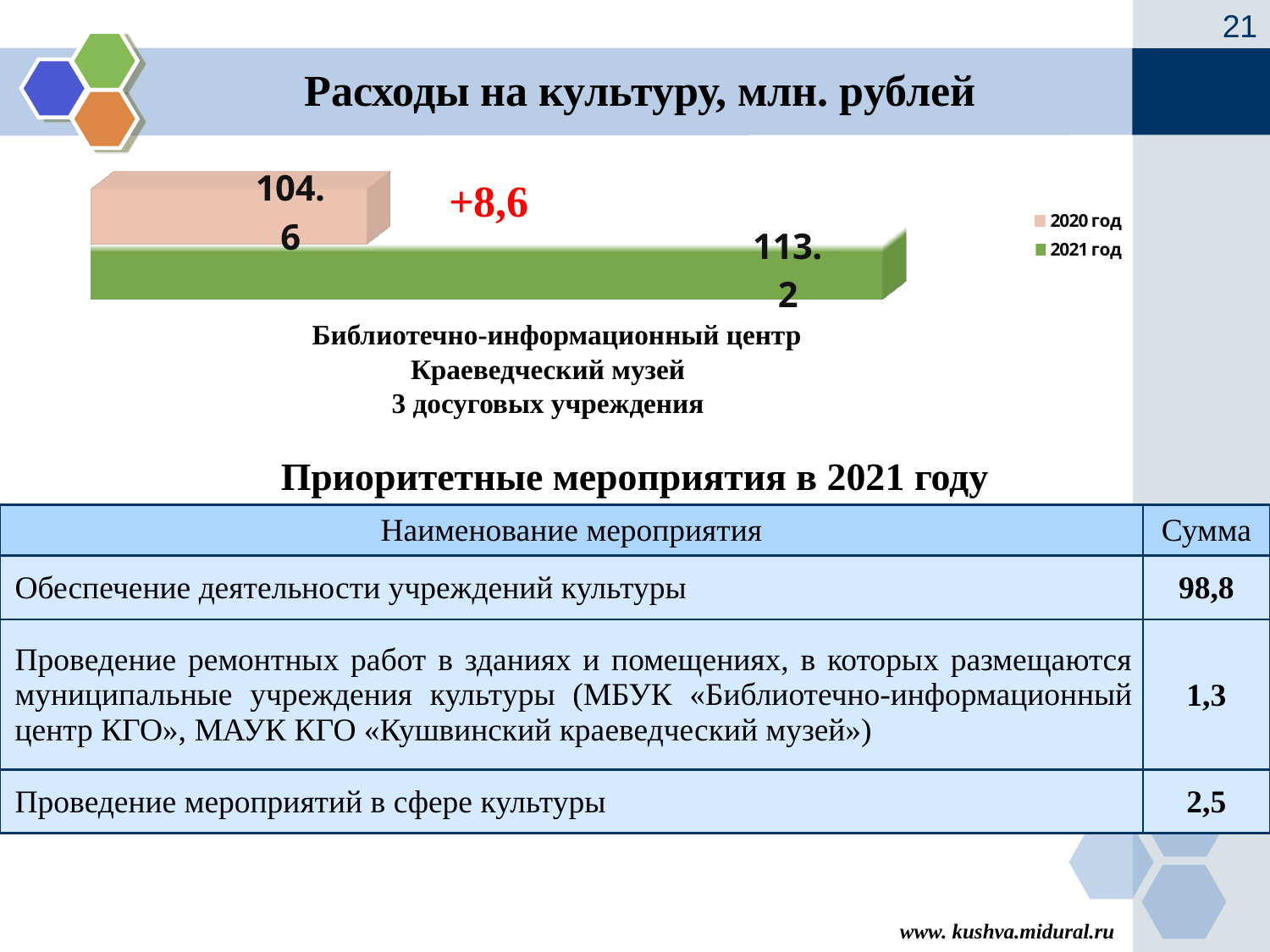
What kind of chart is shown on the slide? bar chart Which series has the highest value in the chart? 2021 год Which series has the lowest value in the chart? 2020 год What is the value for 2021 год in the chart? 113.2 How many series does the chart legend list? 2 What is the title of the chart? Расходы на культуру, млн. рублей What colour is the bar for 2021 год in the chart? green Which year has the higher value in the chart, 2020 год or 2021 год? 2021 год What is the value for 2020 год in the chart? 104.6 How many bars are plotted in the chart? 2 Did the value rise or fall from 2020 год to 2021 год? rise What is the difference between the 2021 год and 2020 год values in the chart? 8,6